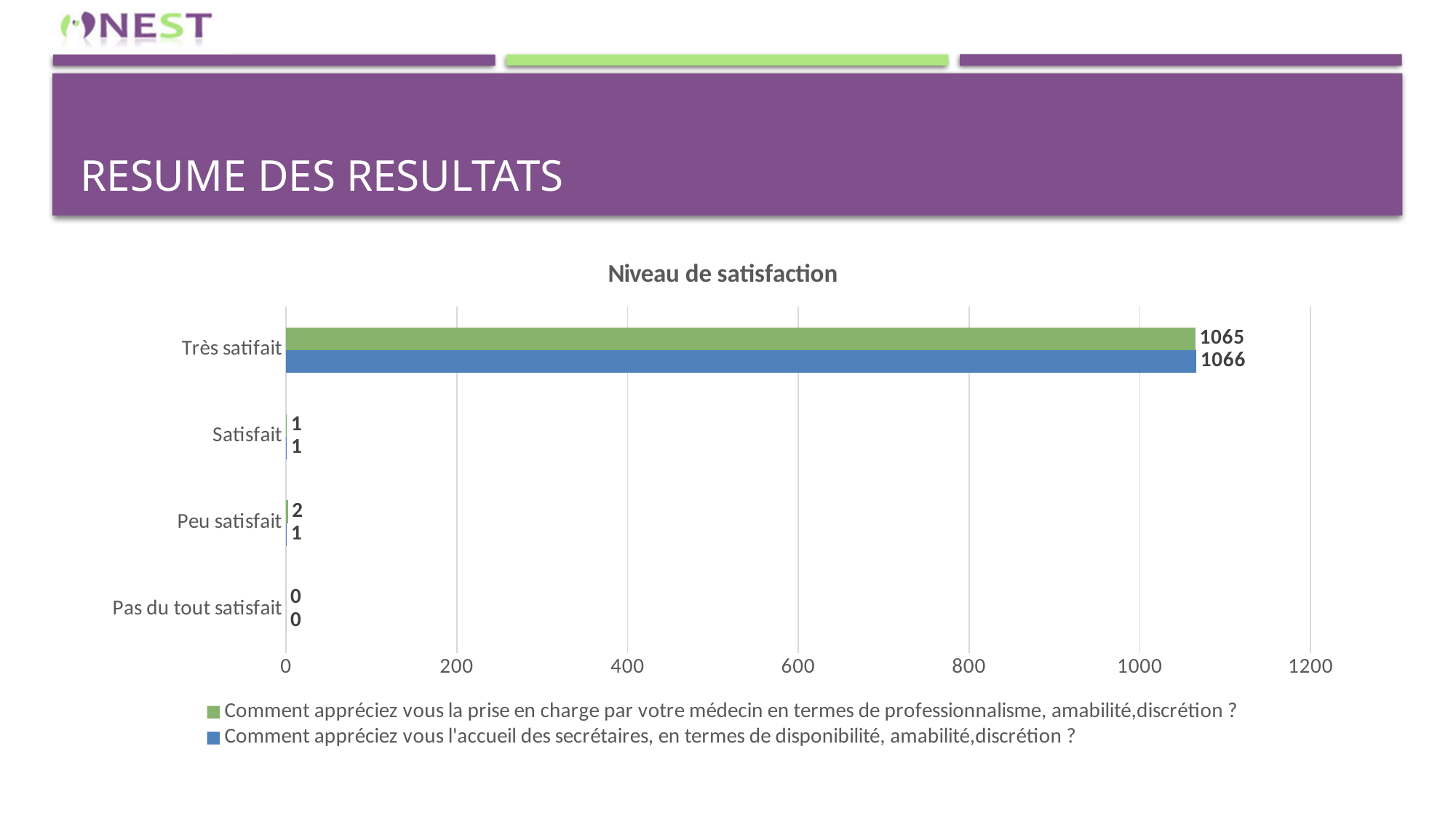
How many series does the legend list? 2 What is the value for 'Pas du tout satisfait' in the series about the accueil des secrétaires? 0 How many satisfaction categories are shown on the chart? 4 Which category has the lowest value in the series about the médecin (prise en charge par votre médecin)? Pas du tout satisfait What is the title of the chart? Niveau de satisfaction What is the value for 'Très satifait' in the series about the médecin (prise en charge par votre médecin)? 1065 Is the value for 'Très satifait' in the series about the médecin greater or less than 1000? greater What kind of chart is shown on the slide? Bar chart What is the value for 'Peu satisfait' in the series about the médecin (prise en charge par votre médecin)? 2 Which category has the highest value in the series about the accueil des secrétaires? Très satifait What is the value for 'Très satifait' in the series about the accueil des secrétaires? 1066 What is the difference between the 'Très satifait' values of the two series? 1